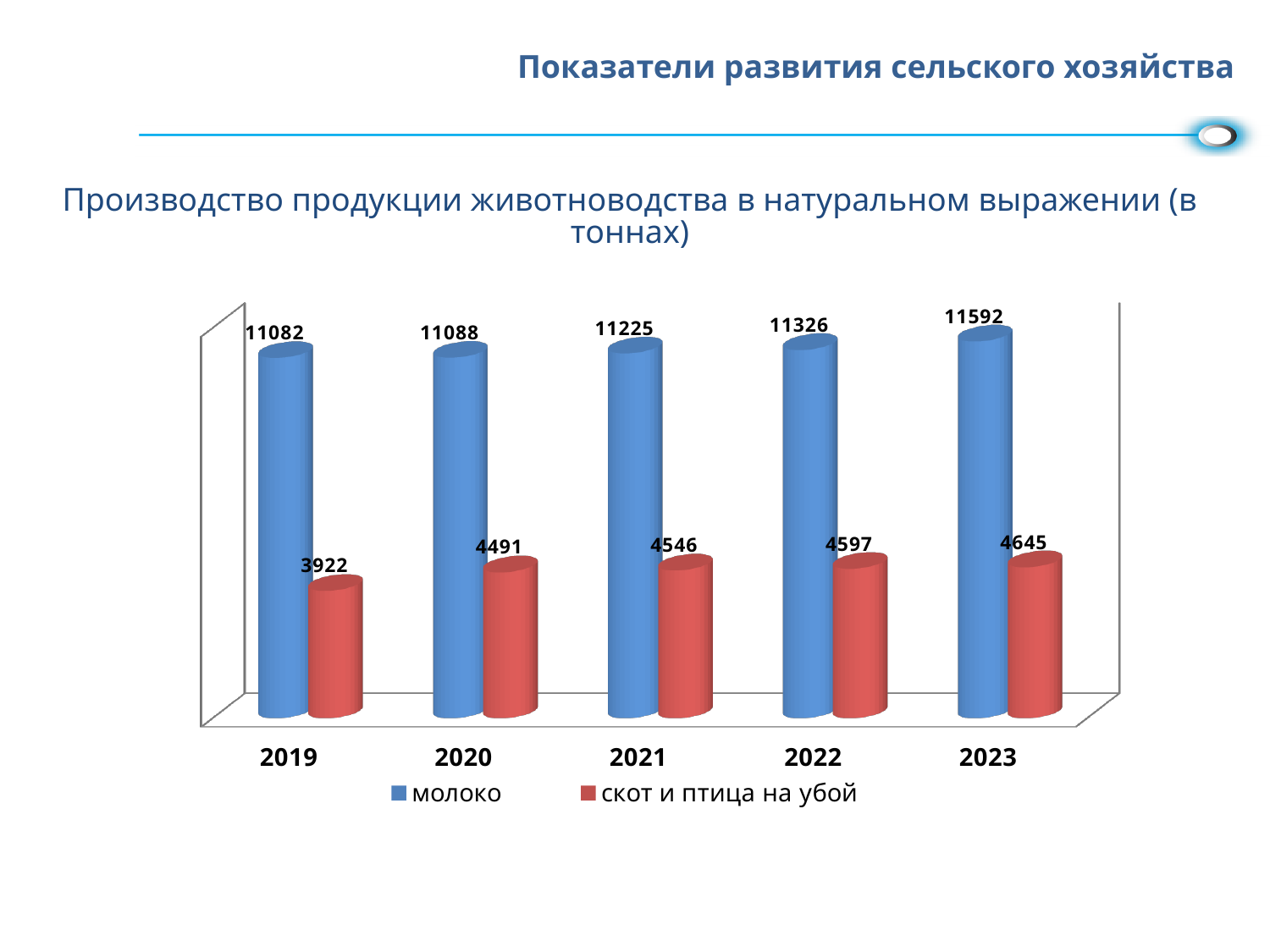
In which year is the value for молоко highest? 2023 How many series does the legend list? 2 What is the value for скот и птица на убой in 2019? 3922 Which is larger in 2022: молоко or скот и птица на убой? молоко What is the value for молоко in 2021? 11225 Do the values for молоко rise or fall from 2019 to 2023? rise What is the value for скот и птица на убой in 2023? 4645 How many years are shown on the x axis? 5 What is the difference between the скот и птица на убой values for 2020 and 2019? 569 In which year is the value for скот и птица на убой lowest? 2019 What is the difference between the молоко values for 2023 and 2019? 510 What kind of chart is shown on the slide? bar chart